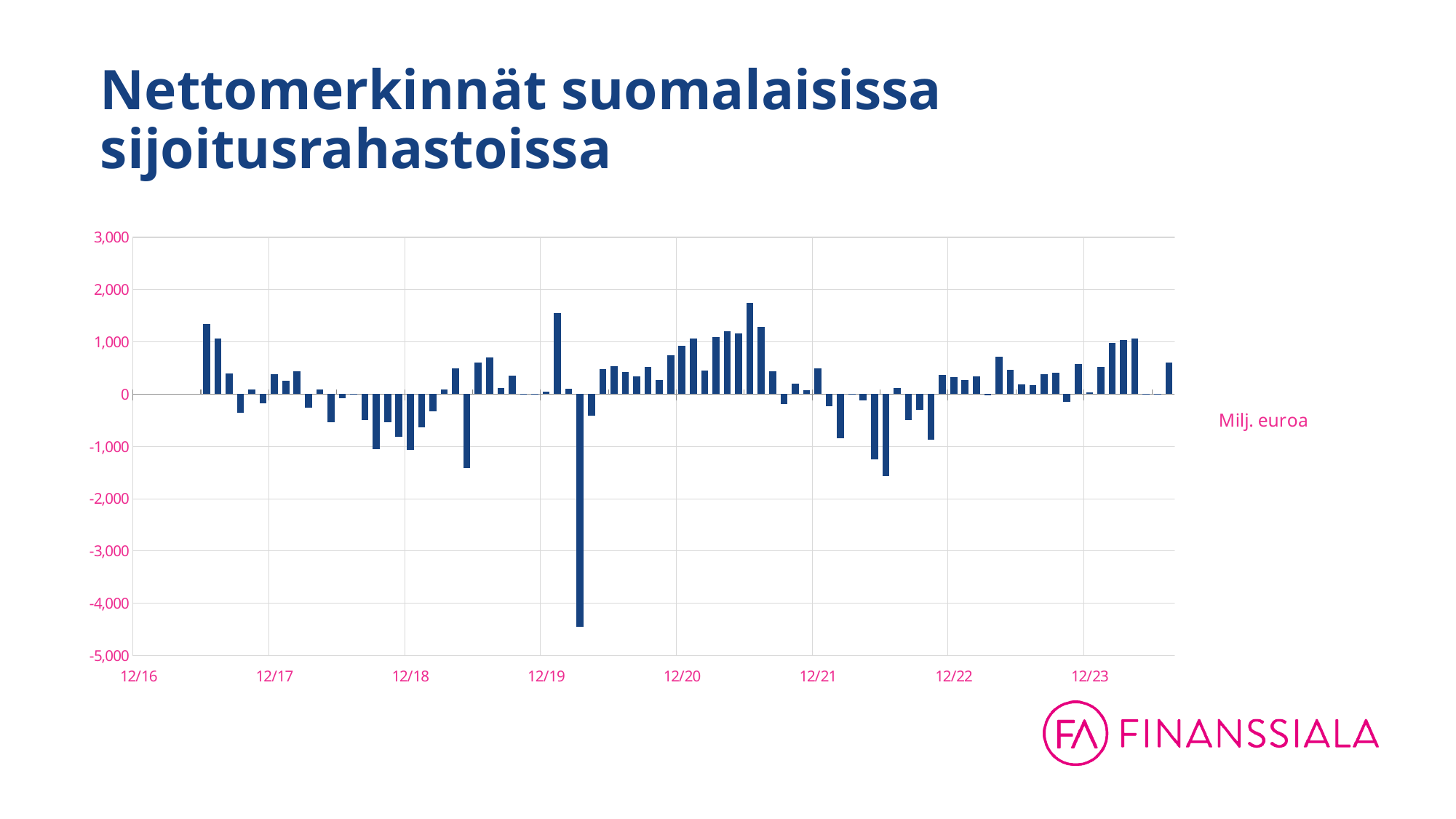
Is the lowest bar in the chart greater or less than -3,000? less What kind of chart is shown on the slide? bar chart Is the highest bar in the chart greater or less than 1,000? greater How many date labels are shown on the x axis? 8 Is the lowest bar greater or less than -5,000? greater What is the title of the chart? Nettomerkinnät suomalaisissa sijoitusrahastoissa What unit label is shown next to the chart? Milj. euroa What is the highest value shown on the y axis? 3,000 Which x-axis date label is the lowest bar closest to? 12/19 How many bars fall below -2,000? 1